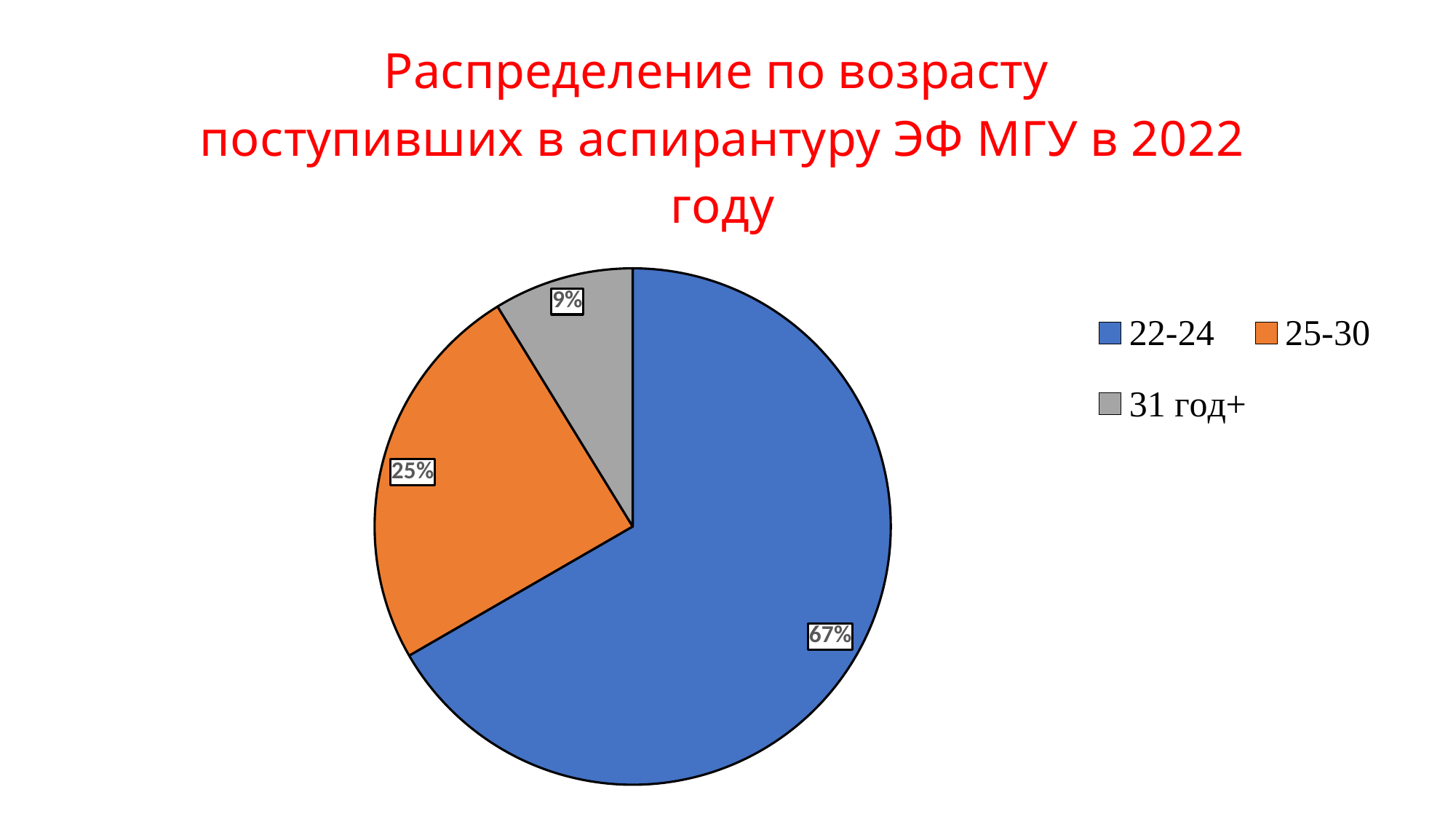
What kind of chart is shown on the slide? pie chart How many age groups are shown in the pie chart? 3 Which age group has the largest share of the pie? 22-24 Which share is larger, 25-30 or 31 год+? 25-30 What is the difference in percentage points between the 25-30 and 31 год+ shares? 16 What share of the pie does the 31 год+ age group have? 9% Which age group has the smallest share of the pie? 31 год+ What colour is the slice for the 25-30 age group? orange What is the difference in percentage points between the 22-24 and 25-30 shares? 42 What is the title of the chart? Распределение по возрасту поступивших в аспирантуру ЭФ МГУ в 2022 году What share of the pie does the 25-30 age group have? 25% What share of the pie does the 22-24 age group have? 67%